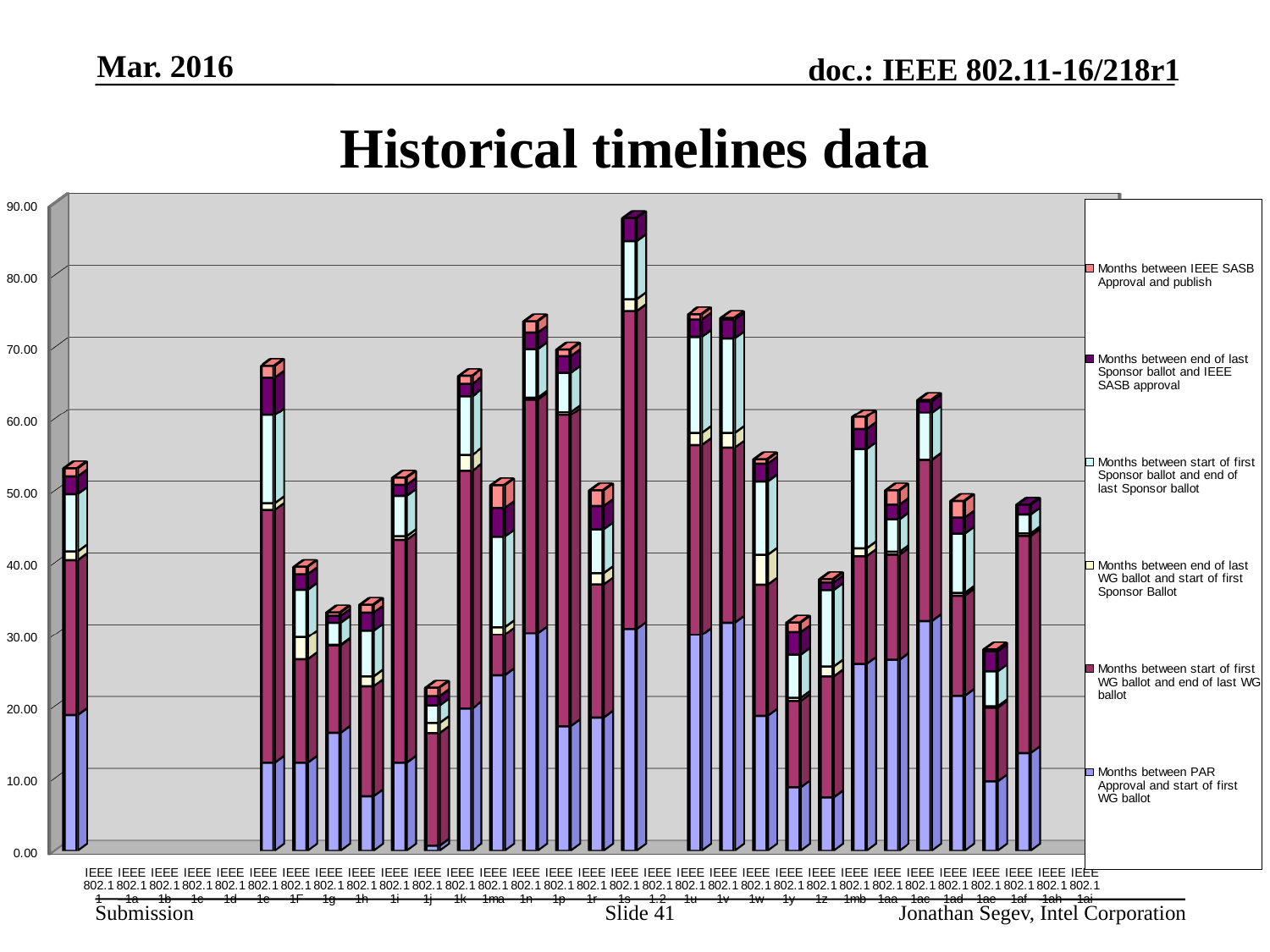
What kind of chart is shown on the slide? bar chart Is the total of the first bar (IEEE 802.11) greater or less than 60? less Which legend entry corresponds to the bottom segment of each stacked bar? Months between PAR Approval and start of first WG ballot How many series does the legend list? 6 What is the title of the chart? Historical timelines data Is the total of the shortest stacked bar greater or less than 30? less Is the total of the first bar (IEEE 802.11) greater or less than 50? greater